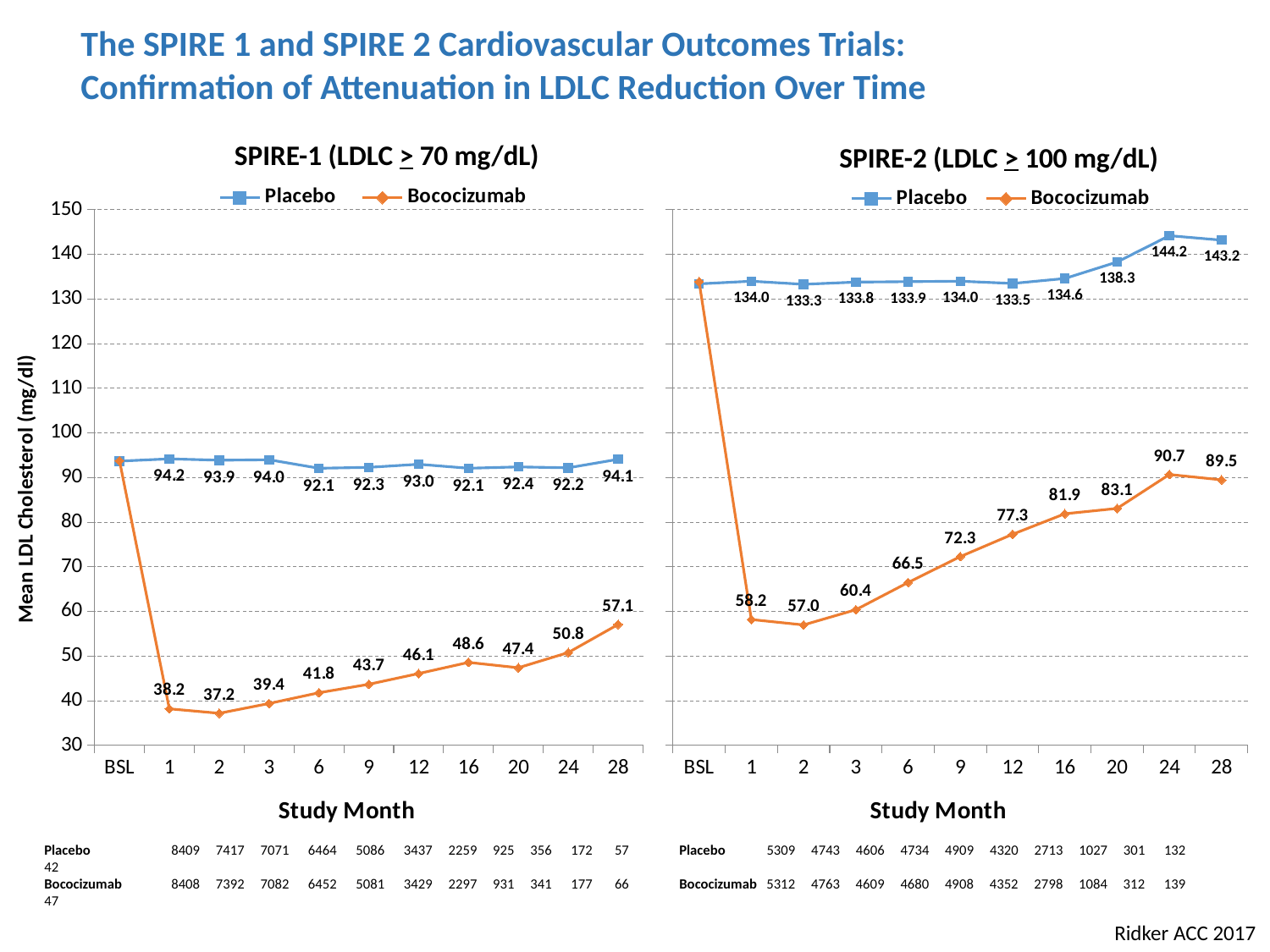
In the SPIRE-1 chart, what is the mean LDL cholesterol for Bococizumab at study month 2? 37.2 In the SPIRE-2 chart, does the Bococizumab value generally rise or fall from study month 2 to study month 24? Rise In the SPIRE-2 chart, is the Bococizumab value at baseline (BSL) greater or less than 120? greater How many study time points are shown on the x axis of the SPIRE-1 chart? 11 In the SPIRE-2 chart, what is the difference between the Placebo and Bococizumab values at study month 28? 53.7 In the SPIRE-2 chart, at which study month is the Bococizumab value lowest? 2 How many series does the legend of the SPIRE-2 chart list? 2 In the SPIRE-1 chart, which is larger: the Bococizumab value at month 16 or at month 20? Month 16 In the SPIRE-2 chart, what is the mean LDL cholesterol for Placebo at study month 24? 144.2 What kind of chart is the SPIRE-1 chart? Line chart In the SPIRE-1 chart, what is the Placebo value at study month 28? 94.1 In the SPIRE-1 chart, at which labelled study month is the Bococizumab value highest? 28